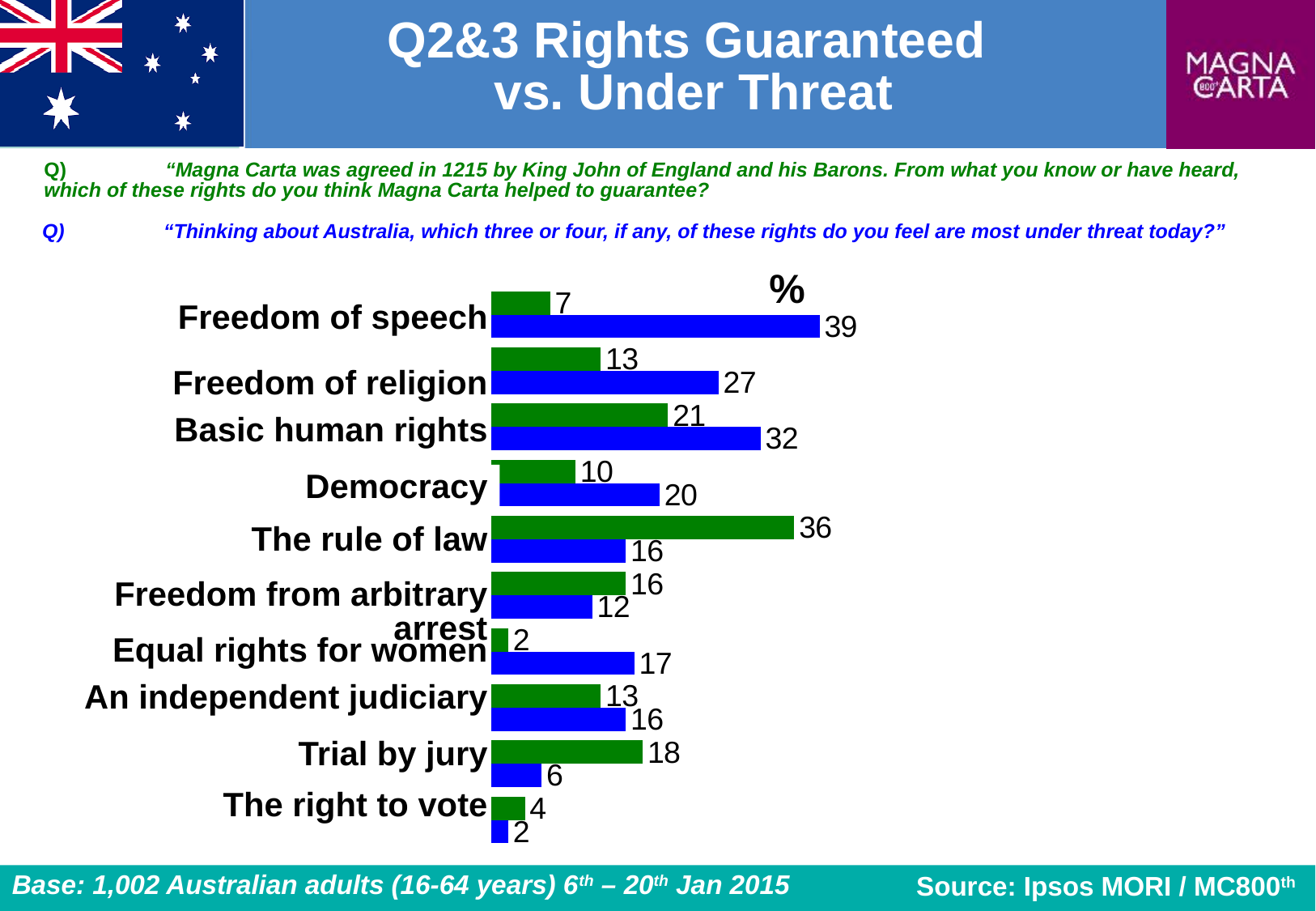
Which category has the lowest blue bar value? The right to vote How many categories are shown in the chart? 10 Which category has the highest blue bar value? Freedom of speech What is the difference between the green and blue bar values for The rule of law? 20 What is the difference between the blue and green bar values for Freedom of speech? 32 What is the value of the green bar for The rule of law? 36 What is the value of the blue bar for Trial by jury? 6 What is the value of the green bar for Equal rights for women? 2 Which category has the highest green bar value? The rule of law What kind of chart is shown on the slide? bar chart For Basic human rights, which bar is larger, the green or the blue? blue What is the value of the blue bar for Freedom of speech? 39